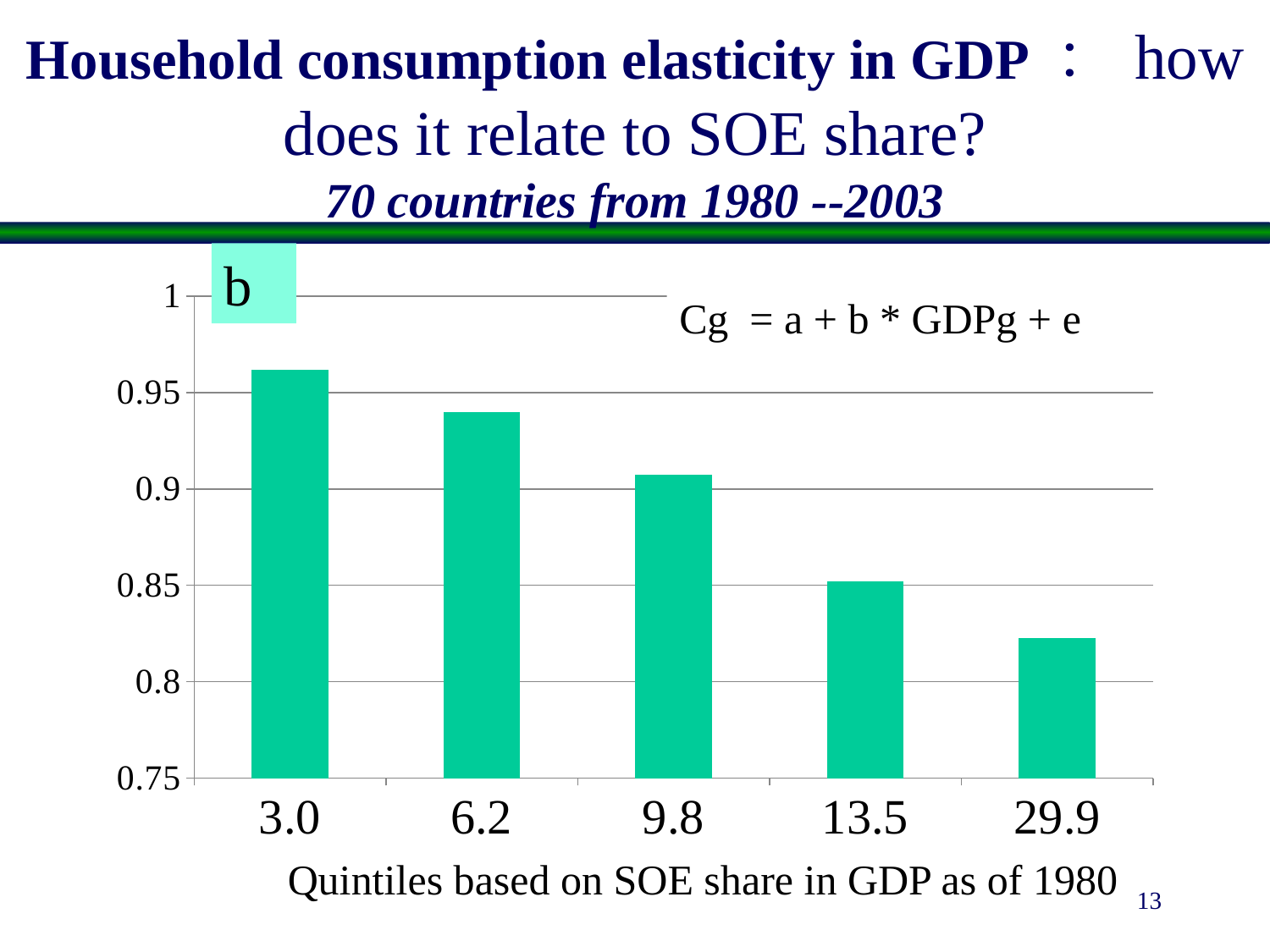
Is the value of b for the 6.2 quintile greater or less than 0.95? less Do the values of b rise or fall as the SOE share quintile increases along the x axis? fall Is the value of b for the 13.5 quintile greater or less than 0.9? less Which quintile has the highest value of b? 3.0 Is the value of b for the 29.9 quintile greater or less than 0.8? greater What kind of chart is shown on the slide? bar chart Which quintile has the lowest value of b? 29.9 What is the label of the x axis of the chart? Quintiles based on SOE share in GDP as of 1980 Which quintile has a larger value of b, 6.2 or 13.5? 6.2 How many quintile categories are plotted on the x axis? 5